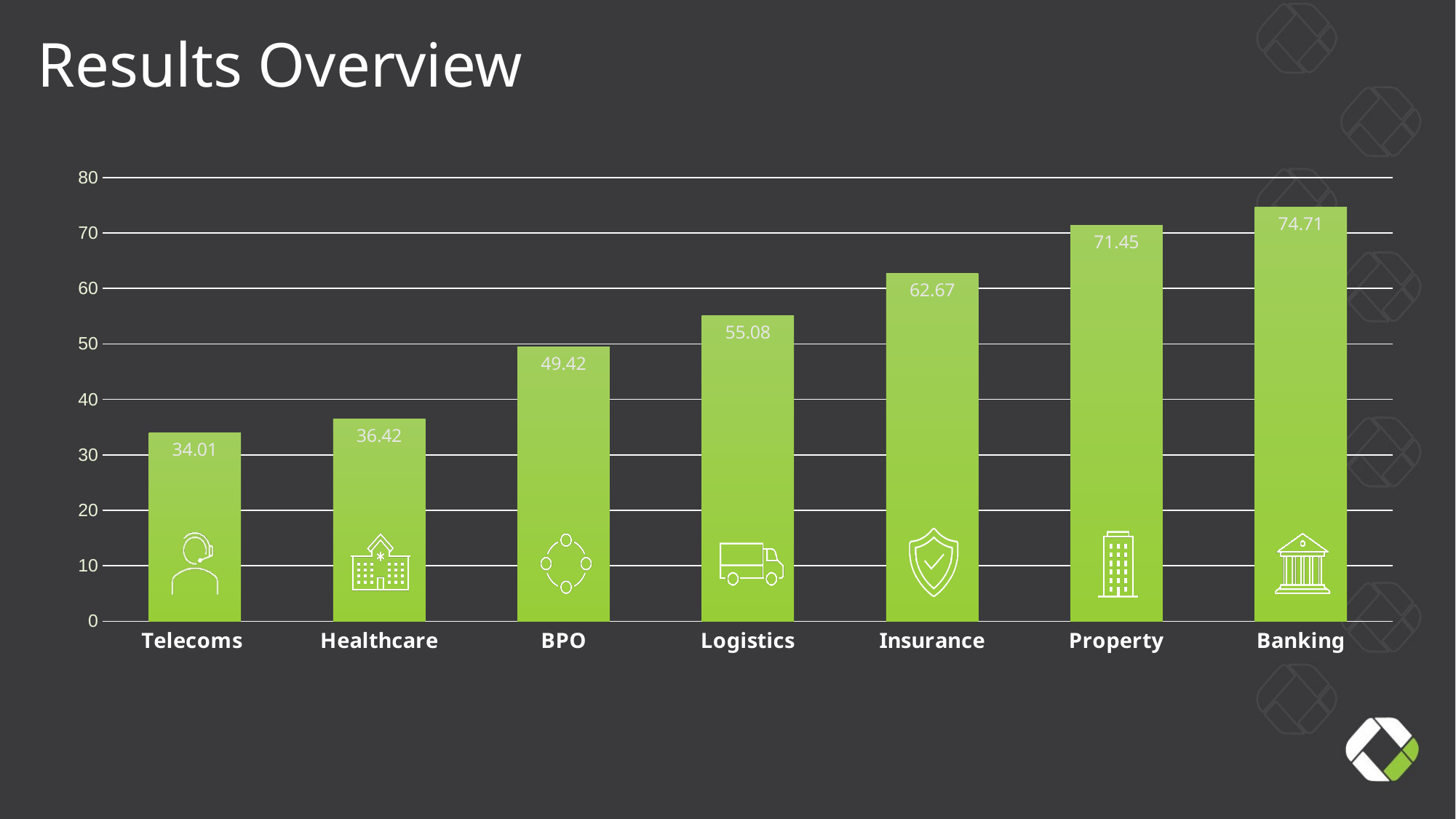
Which is larger, the value for Healthcare or the value for BPO? BPO What is the difference between the values for Insurance and BPO? 13.25 How many categories are shown on the chart? 7 Which category has the lowest value? Telecoms What is the difference between the values for Banking and Telecoms? 40.70 What kind of chart is shown on the slide? Bar chart What is the value for Property? 71.45 What is the value for Telecoms? 34.01 Do the values rise or fall from Telecoms to Banking along the x axis? Rise What is the value for Logistics? 55.08 Which category has the highest value? Banking Is the value for Insurance greater or less than 60? greater